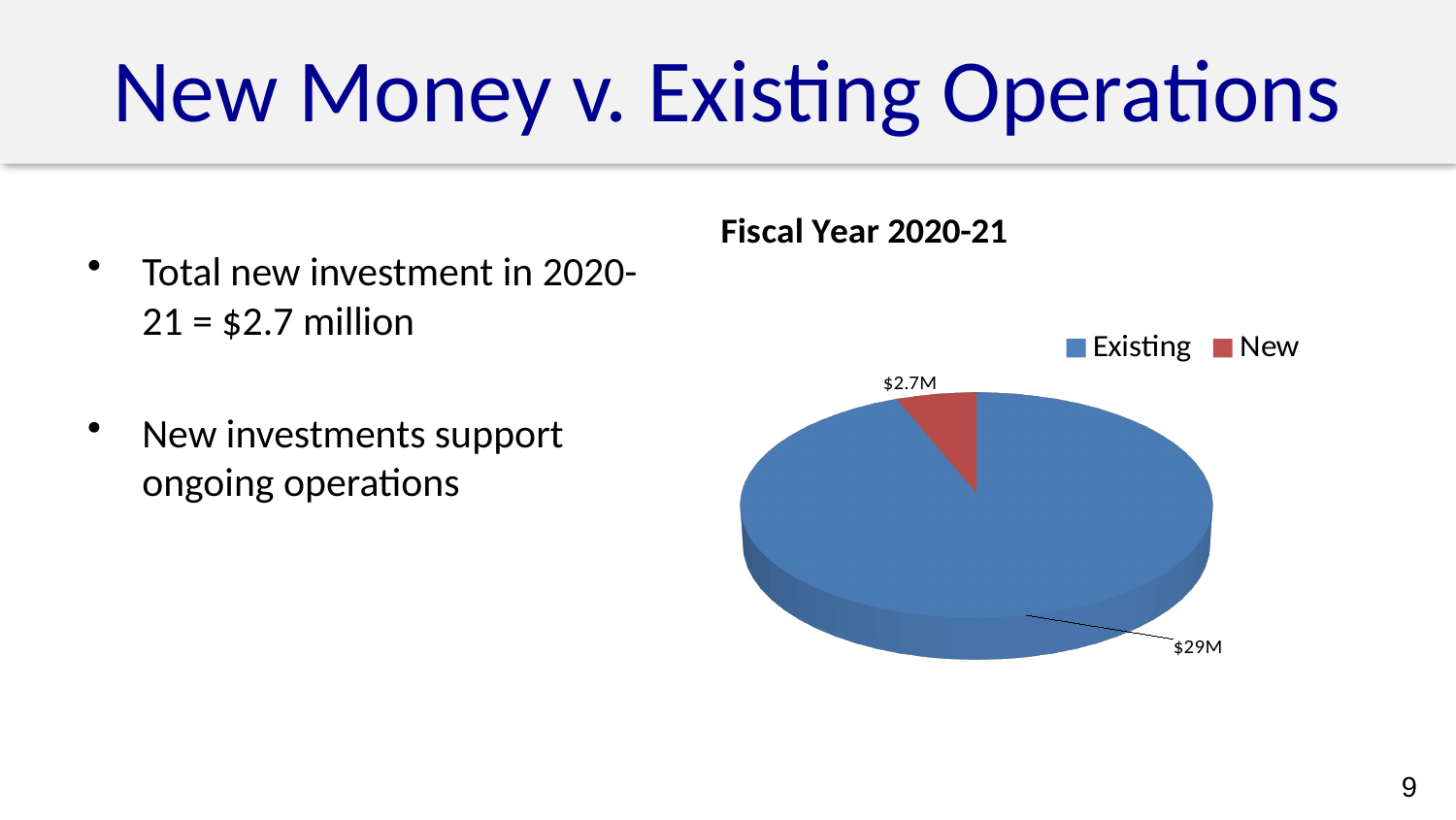
What is the difference between the Existing and New values in the pie chart? $26.3M Which slice of the pie chart is the largest? Existing How many slices does the pie chart have? 2 What colour is the Existing slice in the pie chart? Blue What is the value of the New slice in the pie chart? $2.7M What type of chart is shown on the slide? Pie chart Which slice of the pie chart is the smallest? New What is the title of the chart? Fiscal Year 2020-21 What is the combined total of the Existing and New slices? $31.7M Which is larger in the pie chart, Existing or New? Existing What is the value of the Existing slice in the pie chart? $29M How many entries does the chart legend list? 2